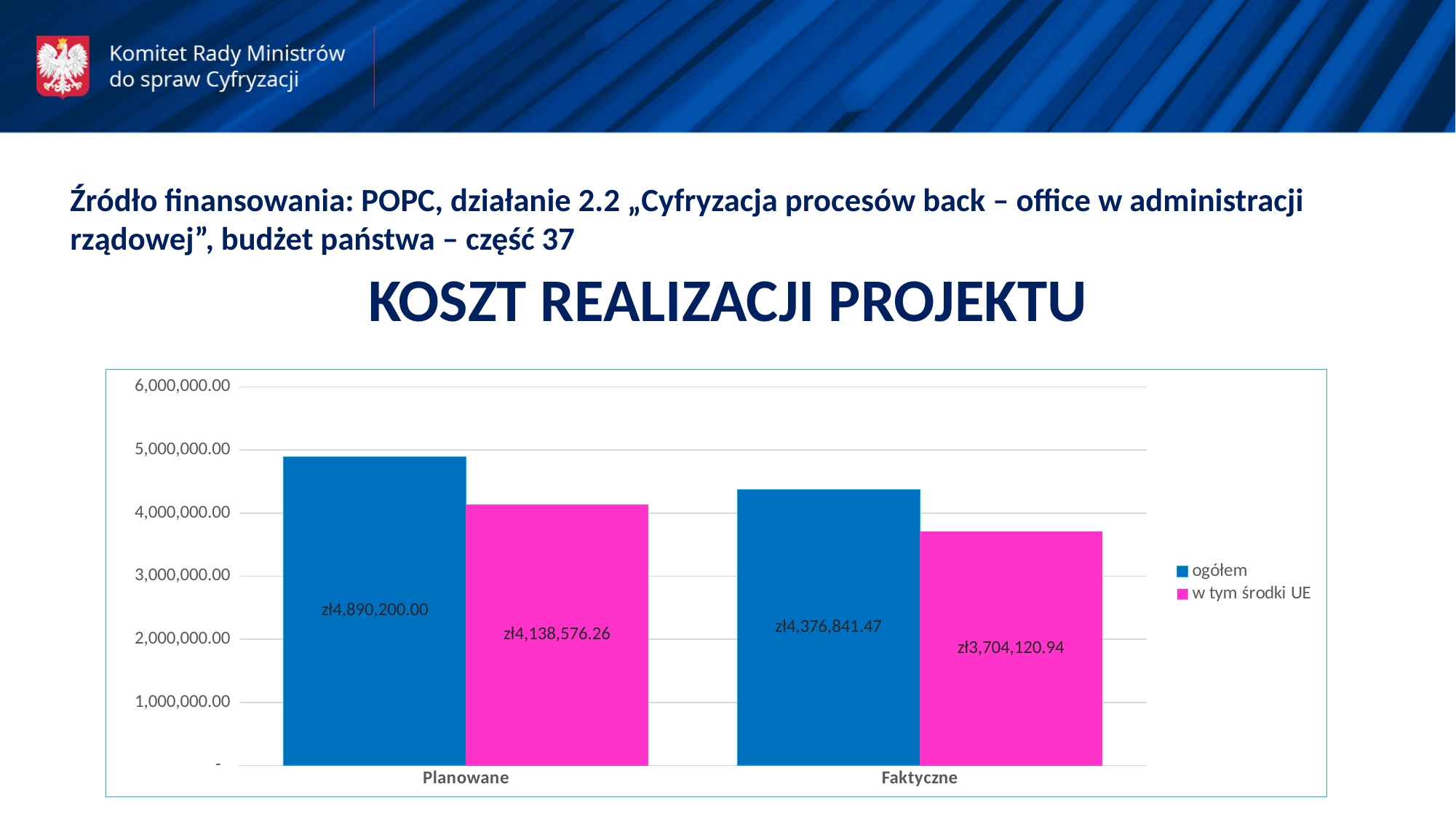
What is the difference between ogółem and w tym środki UE for Planowane? zł751,623.74 What is the difference between the ogółem values for Planowane and Faktyczne? zł513,358.53 What is the value of ogółem for Planowane? zł4,890,200.00 What type of chart is shown on the slide? bar chart What is the value of w tym środki UE for Planowane? zł4,138,576.26 What is the value of w tym środki UE for Faktyczne? zł3,704,120.94 Which is larger: w tym środki UE for Planowane or ogółem for Faktyczne? ogółem for Faktyczne Which bar has the lowest value on the chart? w tym środki UE for Faktyczne Which bar has the highest value on the chart? ogółem for Planowane How many series does the legend list? 2 What is the value of ogółem for Faktyczne? zł4,376,841.47 How many categories are shown on the x axis? 2